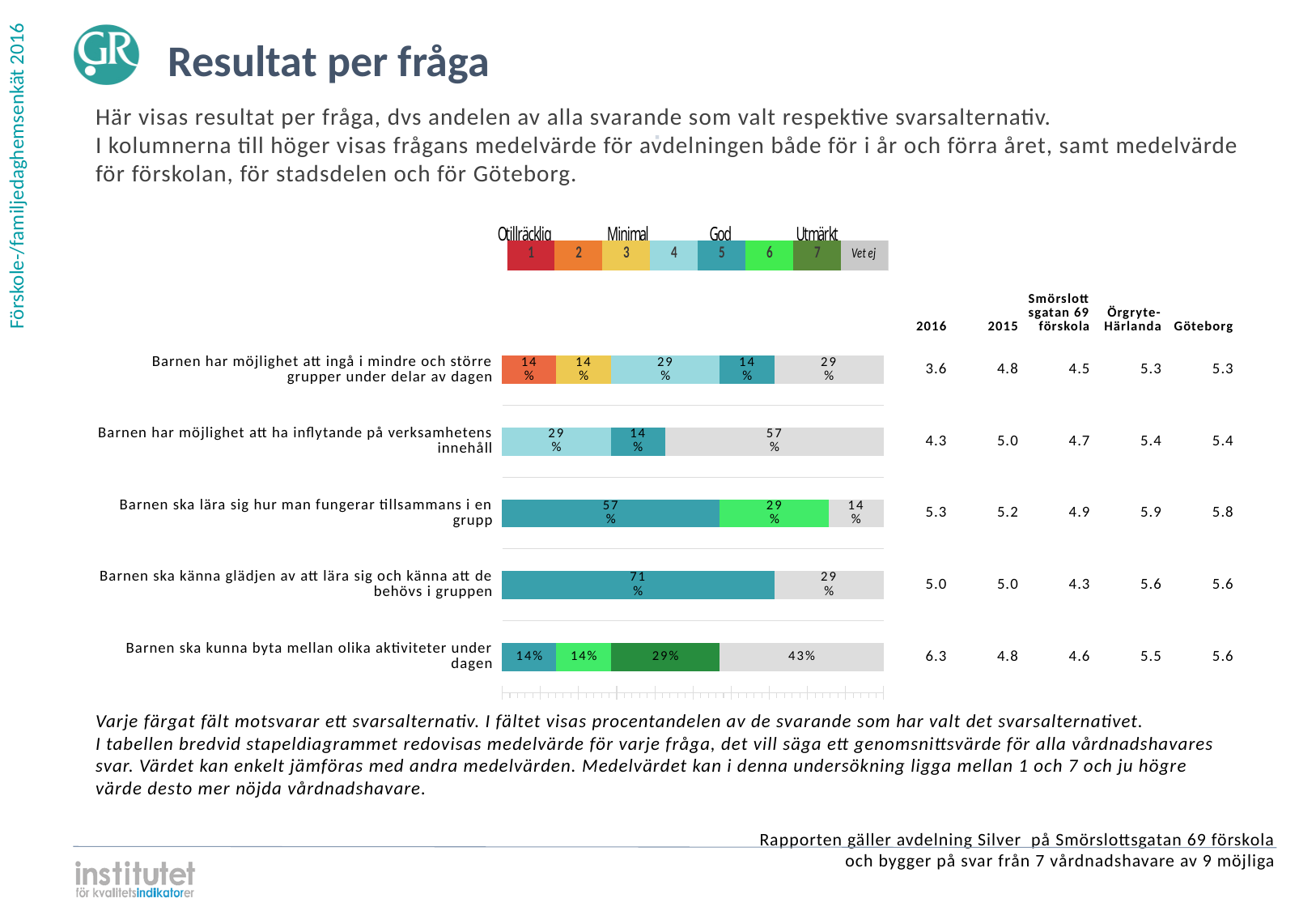
Which question has the lowest 2016 mean value? Barnen har möjlighet att ingå i mindre och större grupper under delar av dagen What is the combined percentage of respondents who chose options 5, 6 and 7 for 'Barnen ska kunna byta mellan olika aktiviteter under dagen'? 57% What kind of chart is used to show the results per question? Stacked bar chart What percentage of respondents chose answer option 7 for 'Barnen ska kunna byta mellan olika aktiviteter under dagen'? 29% Which question has the highest 2016 mean value? Barnen ska kunna byta mellan olika aktiviteter under dagen How many answer categories does the legend above the chart list? 8 What percentage of respondents chose 'Vet ej' for 'Barnen har möjlighet att ha inflytande på verksamhetens innehåll'? 57% What percentage of respondents chose answer option 5 for 'Barnen ska känna glädjen av att lära sig och känna att de behövs i gruppen'? 71% What is the 2016 mean value for 'Barnen ska kunna byta mellan olika aktiviteter under dagen'? 6.3 What is the difference between the 2016 and 2015 mean values for 'Barnen har möjlighet att ingå i mindre och större grupper under delar av dagen'? 1.2 For 'Barnen ska lära sig hur man fungerar tillsammans i en grupp', which is larger: the share choosing option 5 or the share choosing option 6? Option 5 How many questions (bars) are shown in the chart? 5